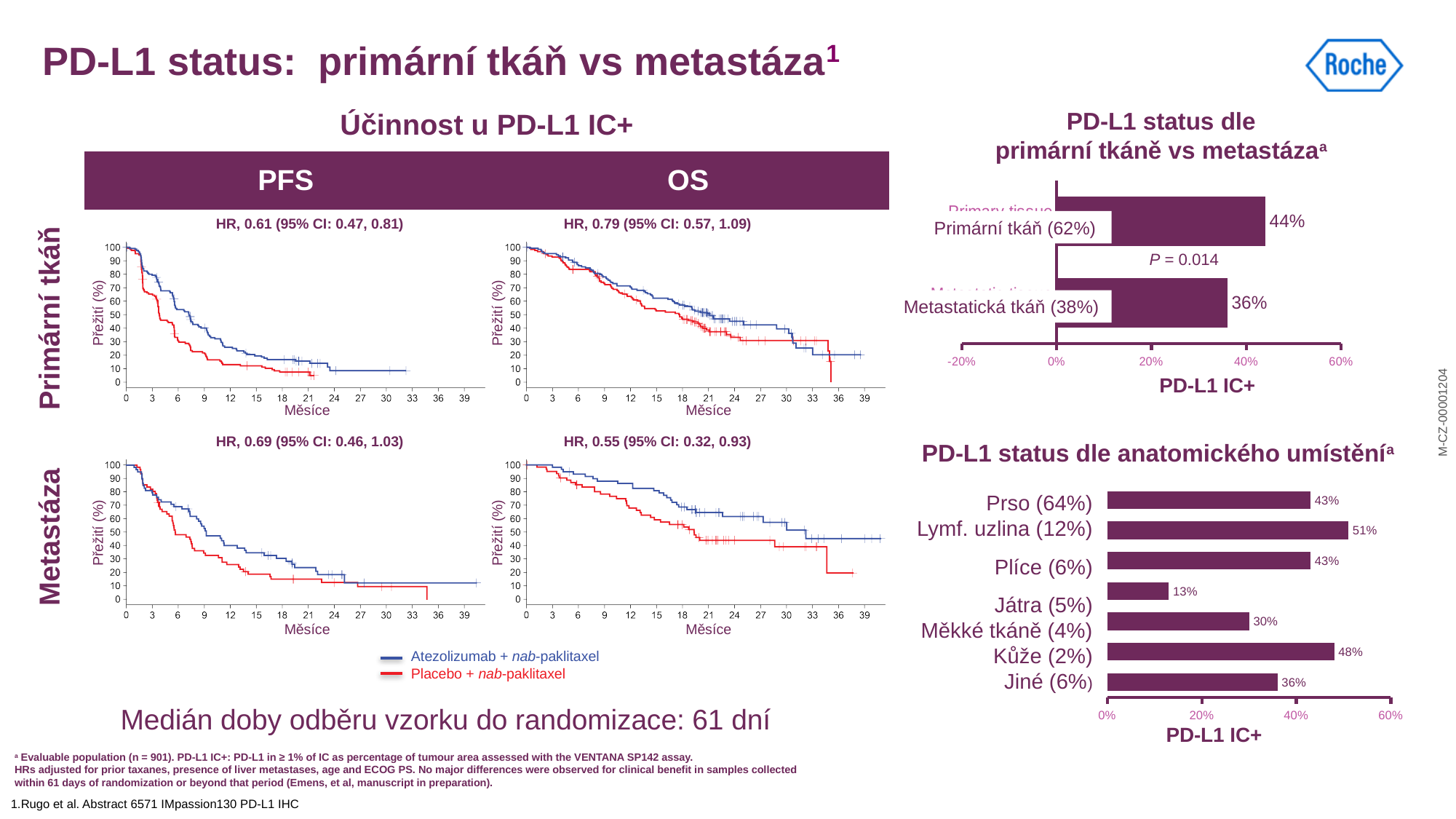
In the chart 'PD-L1 status dle anatomického umístění', what is the PD-L1 IC+ value for Kůže (2%)? 48% How many series does the legend below the survival curves list? 2 In the chart 'PD-L1 status dle anatomického umístění', which category has the lowest PD-L1 IC+ value? Játra (5%) In the chart 'PD-L1 status dle anatomického umístění', how many categories are plotted? 7 In the chart 'PD-L1 status dle primární tkáně vs metastáza', what is the PD-L1 IC+ value for Metastatická tkáň (38%)? 36% In the chart 'PD-L1 status dle anatomického umístění', what is the difference between the values for Lymf. uzlina (12%) and Játra (5%)? 38% What kind of chart is 'PD-L1 status dle anatomického umístění'? Bar chart In the chart 'PD-L1 status dle primární tkáně vs metastáza', what P value is shown between the two bars? P = 0.014 In the chart 'PD-L1 status dle anatomického umístění', which has a larger PD-L1 IC+ value, Prso (64%) or Jiné (6%)? Prso (64%) In the chart 'PD-L1 status dle anatomického umístění', which category has the highest PD-L1 IC+ value? Lymf. uzlina (12%) In the chart 'PD-L1 status dle primární tkáně vs metastáza', what is the PD-L1 IC+ value for Primární tkáň (62%)? 44% In the chart 'PD-L1 status dle primární tkáně vs metastáza', what is the difference between the Primární tkáň and Metastatická tkáň values? 8%